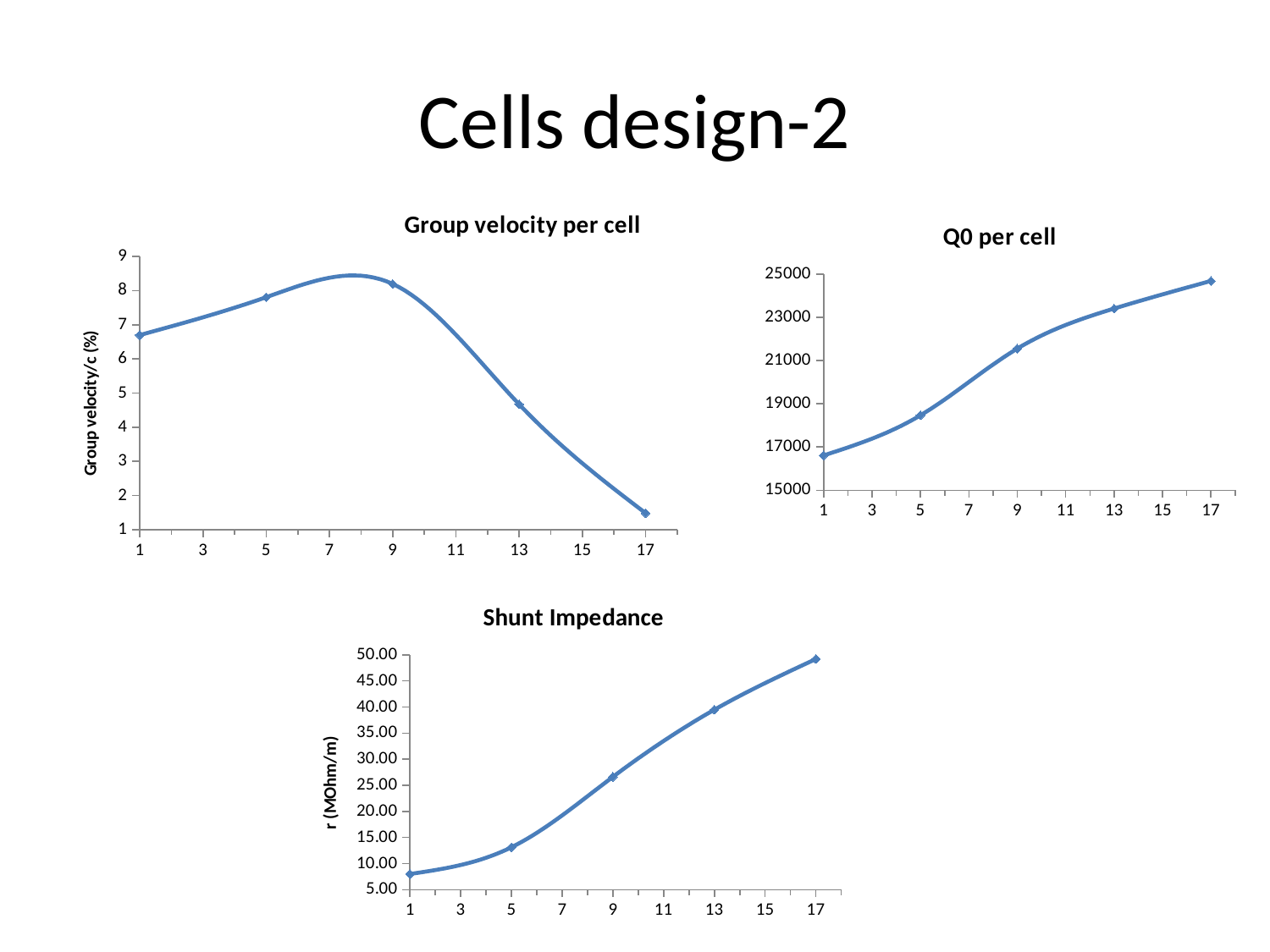
On the "Q0 per cell" chart, do the values rise or fall as the cell number increases? rise On the "Group velocity per cell" chart, at which cell number is the plotted value highest? 9 On the "Group velocity per cell" chart, is the value at cell 17 greater or less than 2? less How many data points are plotted on the "Q0 per cell" chart? 5 On the "Q0 per cell" chart, which is larger, the value at cell 5 or the value at cell 13? cell 13 What kind of chart is the "Group velocity per cell" chart? line chart On the "Group velocity per cell" chart, at which cell number is the plotted value lowest? 17 On the "Group velocity per cell" chart, is the value at cell 5 greater or less than 7? greater On the "Shunt Impedance" chart, at which cell number is the plotted value highest? 17 On the "Q0 per cell" chart, is the value at cell 1 greater or less than 17000? less What is the y-axis label of the "Shunt Impedance" chart? r (MOhm/m)